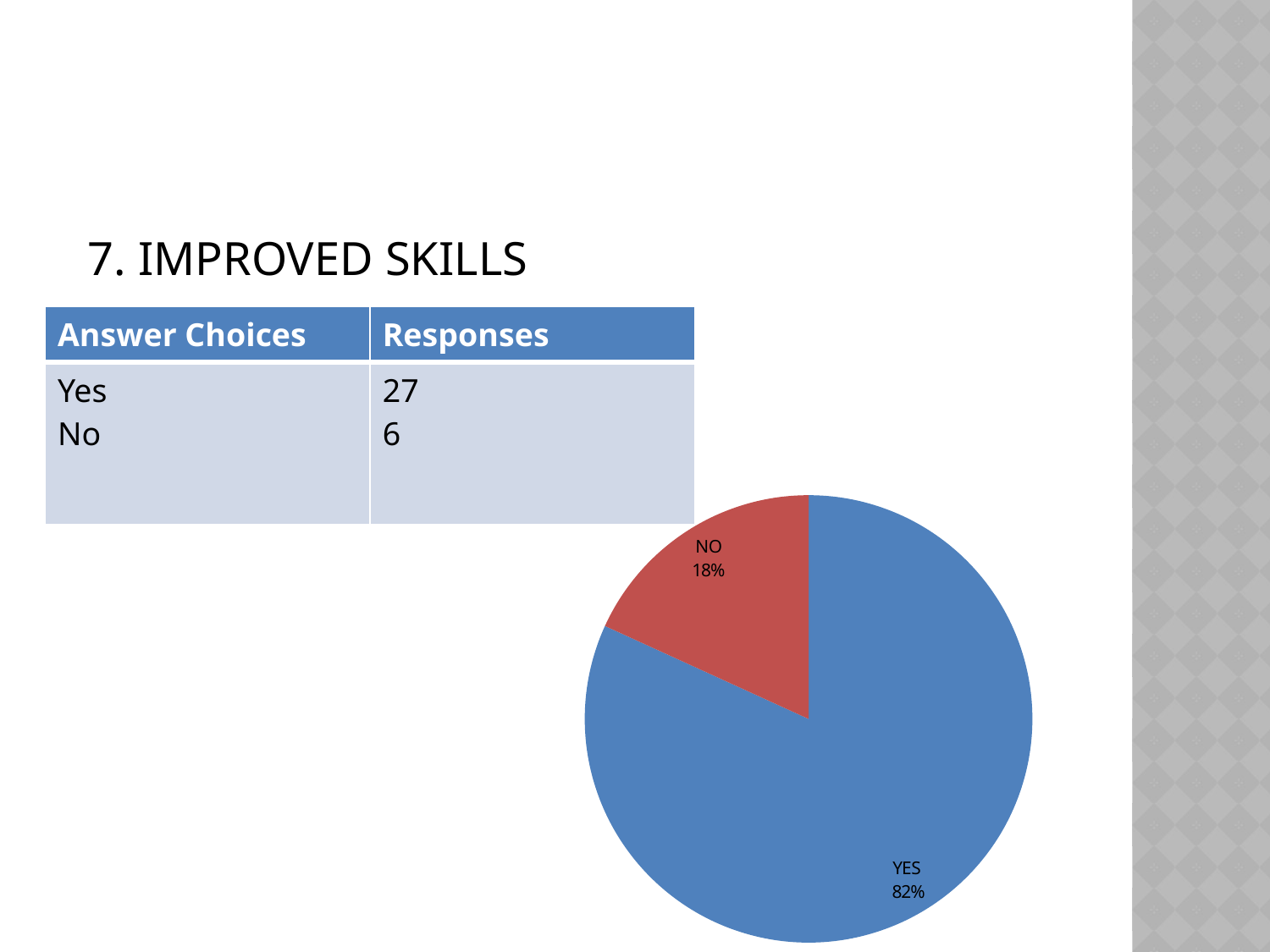
Which slice is larger, YES or NO? YES What percentage of the pie is labelled YES? 82% Is the YES slice greater or less than 50% of the pie? greater Which slice of the pie is the largest? YES Which slice of the pie is the smallest? NO What kind of chart is shown on the slide? pie chart What is the difference in percentage points between the YES and NO slices? 64 What colour is the YES slice of the pie? blue How many slices does the pie chart have? 2 What percentage of the pie is labelled NO? 18% What colour is the NO slice of the pie? red